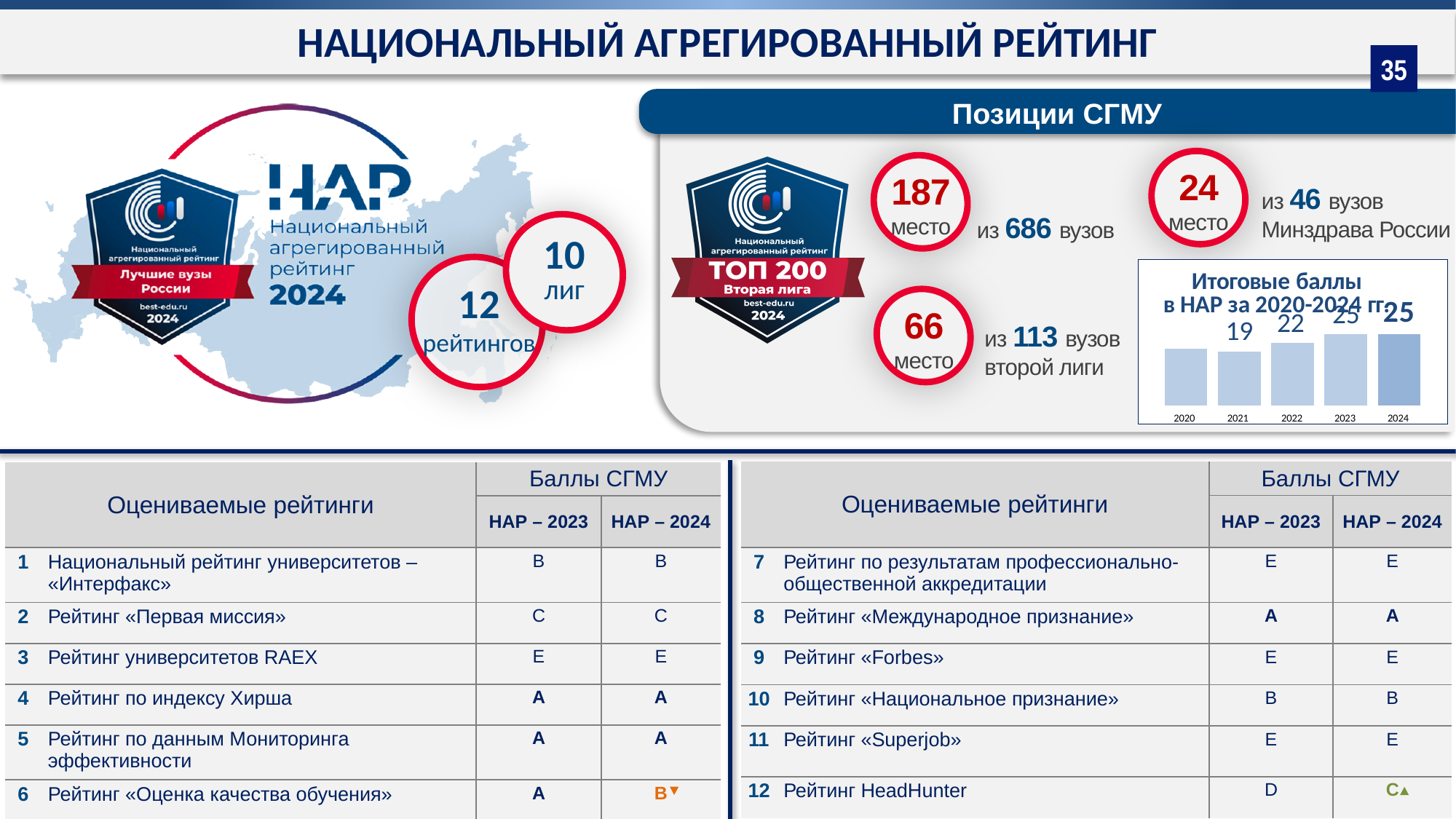
What kind of chart is shown in the 'Итоговые баллы в НАР за 2020-2024 гг' panel? bar chart In the 'Итоговые баллы в НАР' chart, what is the value for 2023? 25 In the 'Итоговые баллы в НАР' chart, what is the difference between the values for 2022 and 2021? 3 In the 'Итоговые баллы в НАР' chart, how many years are shown on the x axis? 5 In the 'Итоговые баллы в НАР' chart, which bar is shown in a darker shade of blue than the others? 2024 What is the title of the chart on the right side of the slide? Итоговые баллы в НАР за 2020-2024 гг In the 'Итоговые баллы в НАР' chart, what is the value for 2022? 22 In the 'Итоговые баллы в НАР' chart, what is the value for 2024? 25 In the 'Итоговые баллы в НАР' chart, do the values generally rise or fall from 2020 to 2024? rise In the 'Итоговые баллы в НАР' chart, which year has the larger value, 2021 or 2022? 2022 In the 'Итоговые баллы в НАР' chart, what is the difference between the values for 2024 and 2021? 6 In the 'Итоговые баллы в НАР' chart, what is the value for 2021? 19